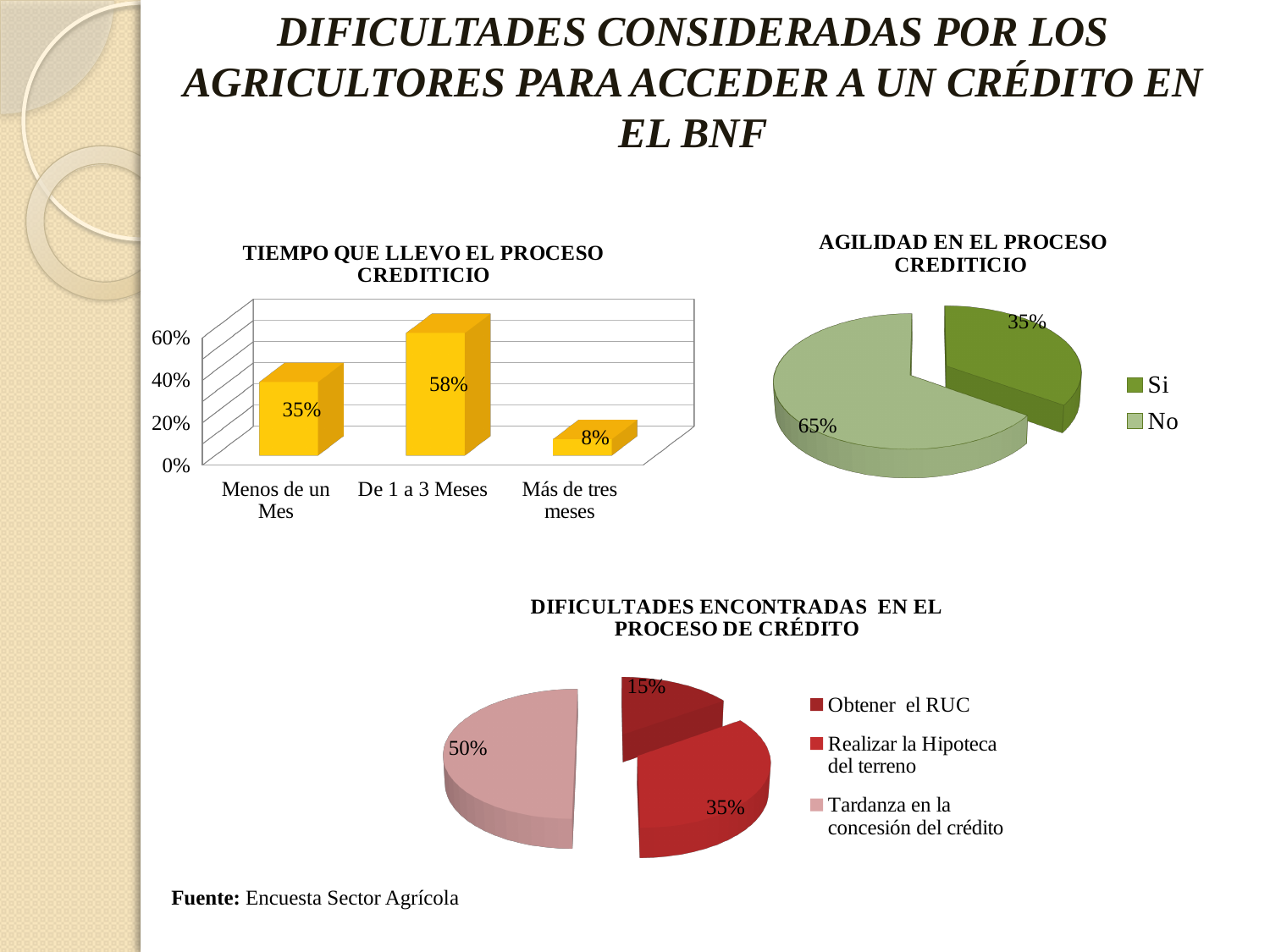
How many entries does the legend of the chart 'DIFICULTADES ENCONTRADAS EN EL PROCESO DE CRÉDITO' list? 3 In the chart 'TIEMPO QUE LLEVO EL PROCESO CREDITICIO', what is the difference between 'De 1 a 3 Meses' and 'Menos de un Mes'? 23% In the chart 'TIEMPO QUE LLEVO EL PROCESO CREDITICIO', which category has the highest value? De 1 a 3 Meses In the pie chart 'AGILIDAD EN EL PROCESO CREDITICIO', what share is 'No'? 65% What kind of chart is 'TIEMPO QUE LLEVO EL PROCESO CREDITICIO'? Bar chart In the pie chart 'DIFICULTADES ENCONTRADAS EN EL PROCESO DE CRÉDITO', which category has the largest share? Tardanza en la concesión del crédito In the chart 'TIEMPO QUE LLEVO EL PROCESO CREDITICIO', what is the value for 'De 1 a 3 Meses'? 58% In the pie chart 'AGILIDAD EN EL PROCESO CREDITICIO', which is larger, 'Si' or 'No'? No How many categories are shown in the chart 'TIEMPO QUE LLEVO EL PROCESO CREDITICIO'? 3 In the chart 'TIEMPO QUE LLEVO EL PROCESO CREDITICIO', which category has the lowest value? Más de tres meses In the pie chart 'DIFICULTADES ENCONTRADAS EN EL PROCESO DE CRÉDITO', what share is 'Obtener el RUC'? 15% What kind of chart is 'AGILIDAD EN EL PROCESO CREDITICIO'? Pie chart